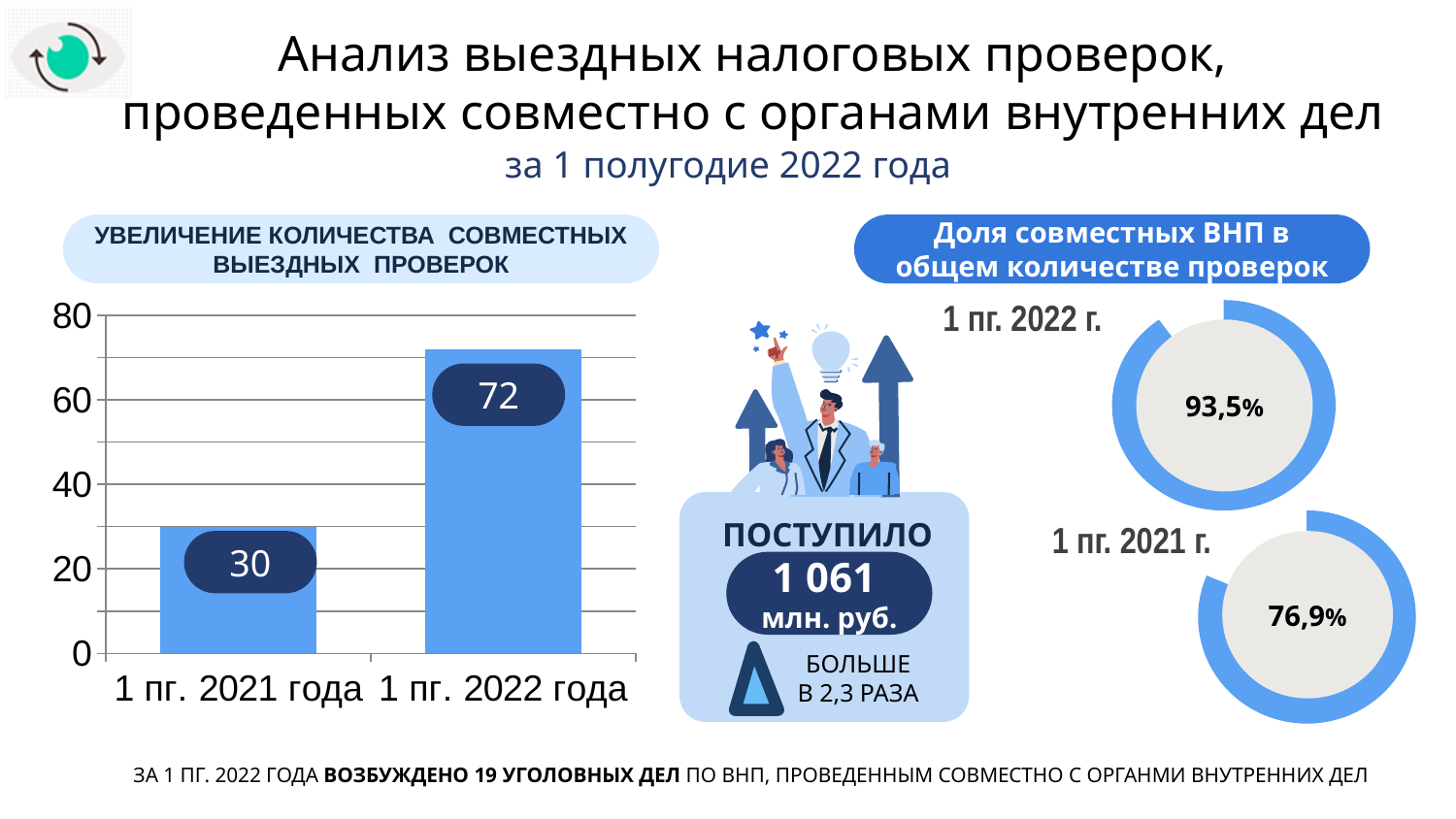
In the bar chart on the left, how many categories are shown? 2 What kind of chart is shown on the left of the slide? bar chart In the bar chart on the left, do the values rise or fall from 1 пг. 2021 года to 1 пг. 2022 года? rise In the ring charts on the right (Доля совместных ВНП в общем количестве проверок), what is the share for 1 пг. 2021 г.? 76,9% In the bar chart on the left, is the value for 1 пг. 2022 года greater or less than 60? greater In the bar chart on the left, what is the value for 1 пг. 2021 года? 30 In the bar chart on the left, what is the difference between the values for 1 пг. 2022 года and 1 пг. 2021 года? 42 In the ring charts on the right, which period has the larger share, 1 пг. 2022 г. or 1 пг. 2021 г.? 1 пг. 2022 г. In the ring charts on the right (Доля совместных ВНП в общем количестве проверок), what is the share for 1 пг. 2022 г.? 93,5% In the bar chart on the left, what is the value for 1 пг. 2022 года? 72 In the bar chart on the left, which category has the highest value? 1 пг. 2022 года In the bar chart on the left, which category has the lowest value? 1 пг. 2021 года